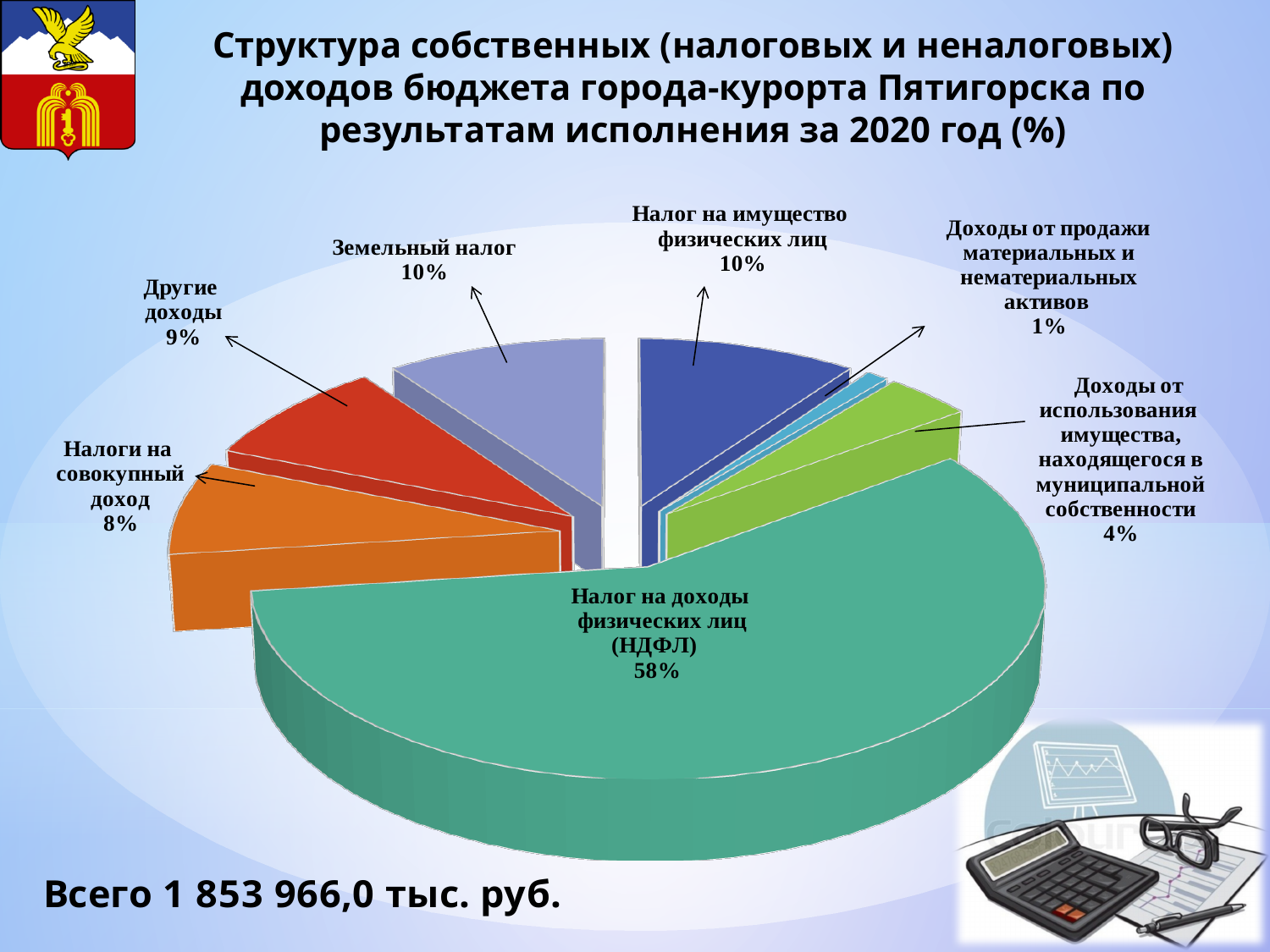
What total amount in thousand rubles is stated below the chart? 1 853 966,0 тыс. руб. What is the value shown for "Земельный налог"? 10% What share of the pie does "Налог на доходы физических лиц (НДФЛ)" have? 58% How many slices does the pie chart have? 7 What kind of chart is shown on the slide? pie chart Which is larger: the share of "Другие доходы" or the share of "Доходы от использования имущества, находящегося в муниципальной собственности"? Другие доходы What is the difference between the shares of "Другие доходы" and "Налоги на совокупный доход"? 1% Which category has the largest slice of the pie? Налог на доходы физических лиц (НДФЛ) What is the difference between the share of "Налог на доходы физических лиц (НДФЛ)" and the share of "Налог на имущество физических лиц"? 48% Which category has the smallest slice of the pie? Доходы от продажи материальных и нематериальных активов What is the value shown for "Доходы от использования имущества, находящегося в муниципальной собственности"? 4% What is the value shown for "Налоги на совокупный доход"? 8%